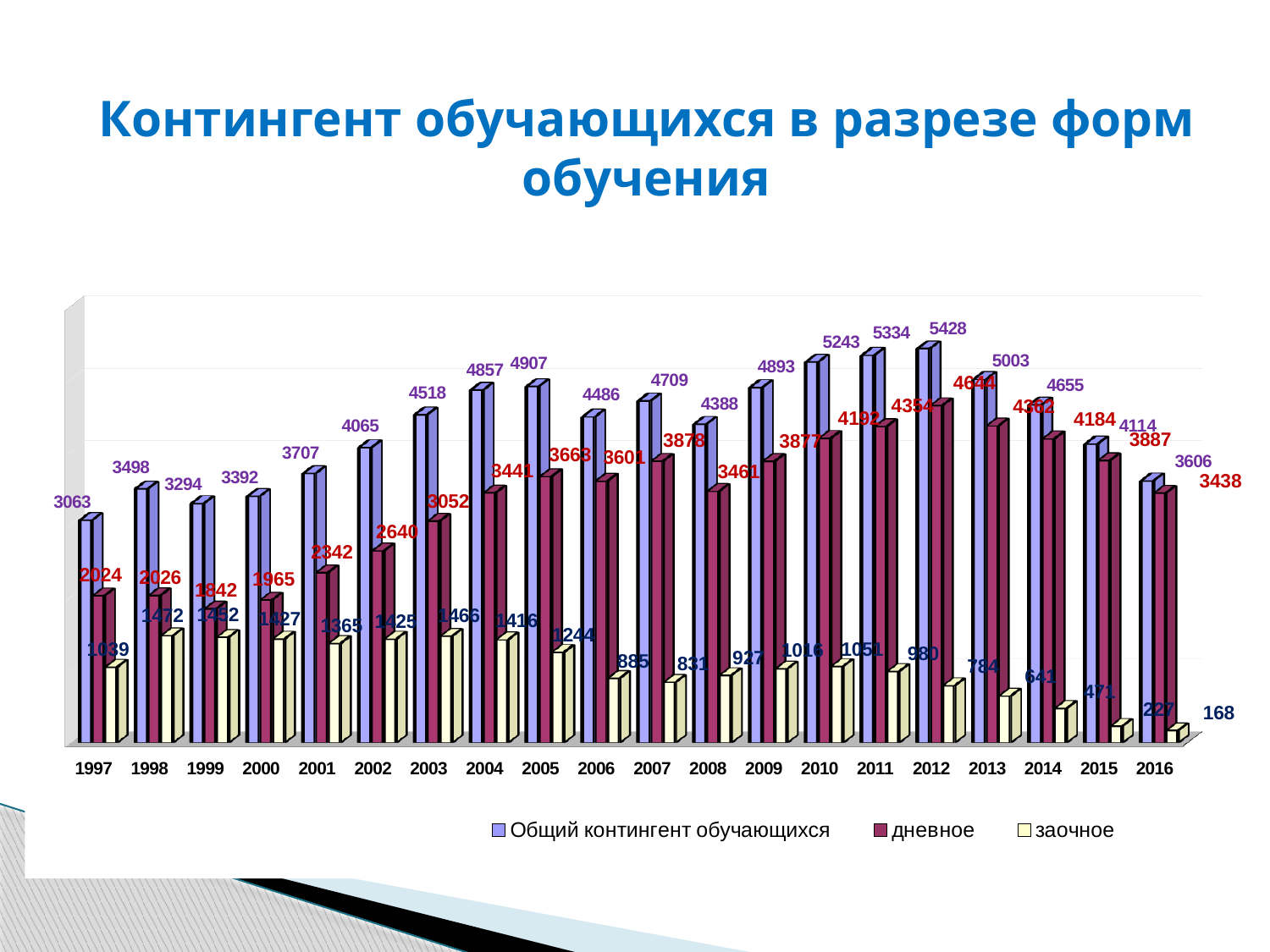
How many years are shown along the x axis? 20 Which is larger: 'дневное' in 2005 or 'дневное' in 2006? 2005 What is the value of 'Общий контингент обучающихся' in 2012? 5428 What is the value of 'заочное' in 2016? 168 In which year is 'Общий контингент обучающихся' lowest? 1997 How many series does the legend list? 3 What is the value of 'дневное' in 2010? 4192 Does 'заочное' rise or fall from 2010 to 2016? fall What kind of chart is shown on the slide? bar chart What is the difference between 'Общий контингент обучающихся' in 2012 and in 2011? 94 In which year is 'Общий контингент обучающихся' highest? 2012 In which year is 'заочное' highest? 1998